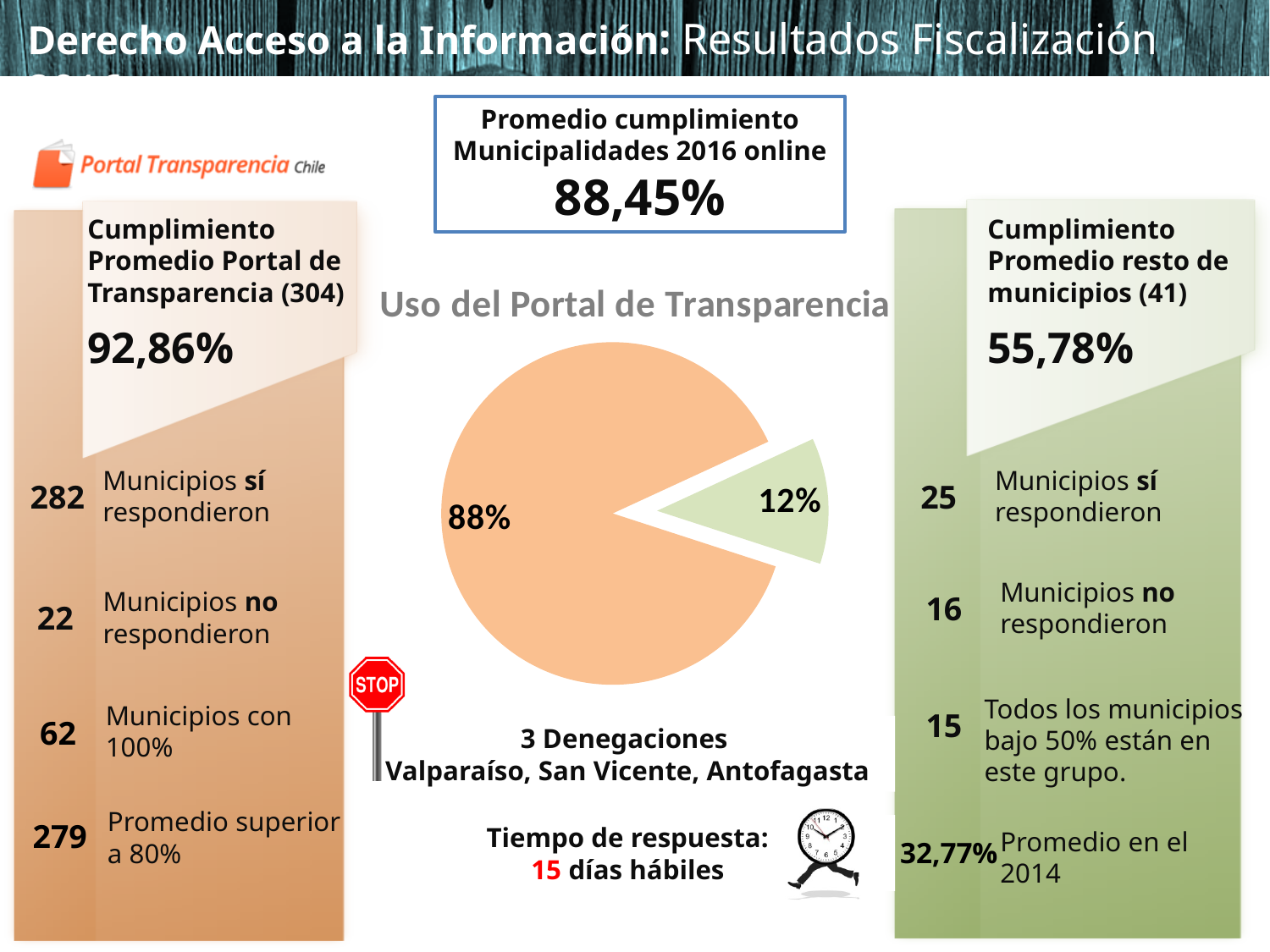
In the pie chart "Uso del Portal de Transparencia", what is the difference in percentage points between the orange slice and the green slice? 76 percentage points In the pie chart "Uso del Portal de Transparencia", which slice is the smallest? the green slice (12%) In the pie chart "Uso del Portal de Transparencia", is the green slice greater or less than 50% of the pie? less What is the title of the pie chart on the slide? Uso del Portal de Transparencia How many slices does the pie chart "Uso del Portal de Transparencia" have? 2 In the pie chart "Uso del Portal de Transparencia", what share is shown on the small green slice? 12% Which slice of the pie chart "Uso del Portal de Transparencia" is pulled out (exploded) from the rest of the pie? the green 12% slice What kind of chart is shown under the title "Uso del Portal de Transparencia"? pie chart In the pie chart "Uso del Portal de Transparencia", what share is shown on the large orange slice? 88% In the pie chart "Uso del Portal de Transparencia", which slice is the largest? the orange slice (88%) In the pie chart "Uso del Portal de Transparencia", is the orange slice or the green slice larger? the orange slice